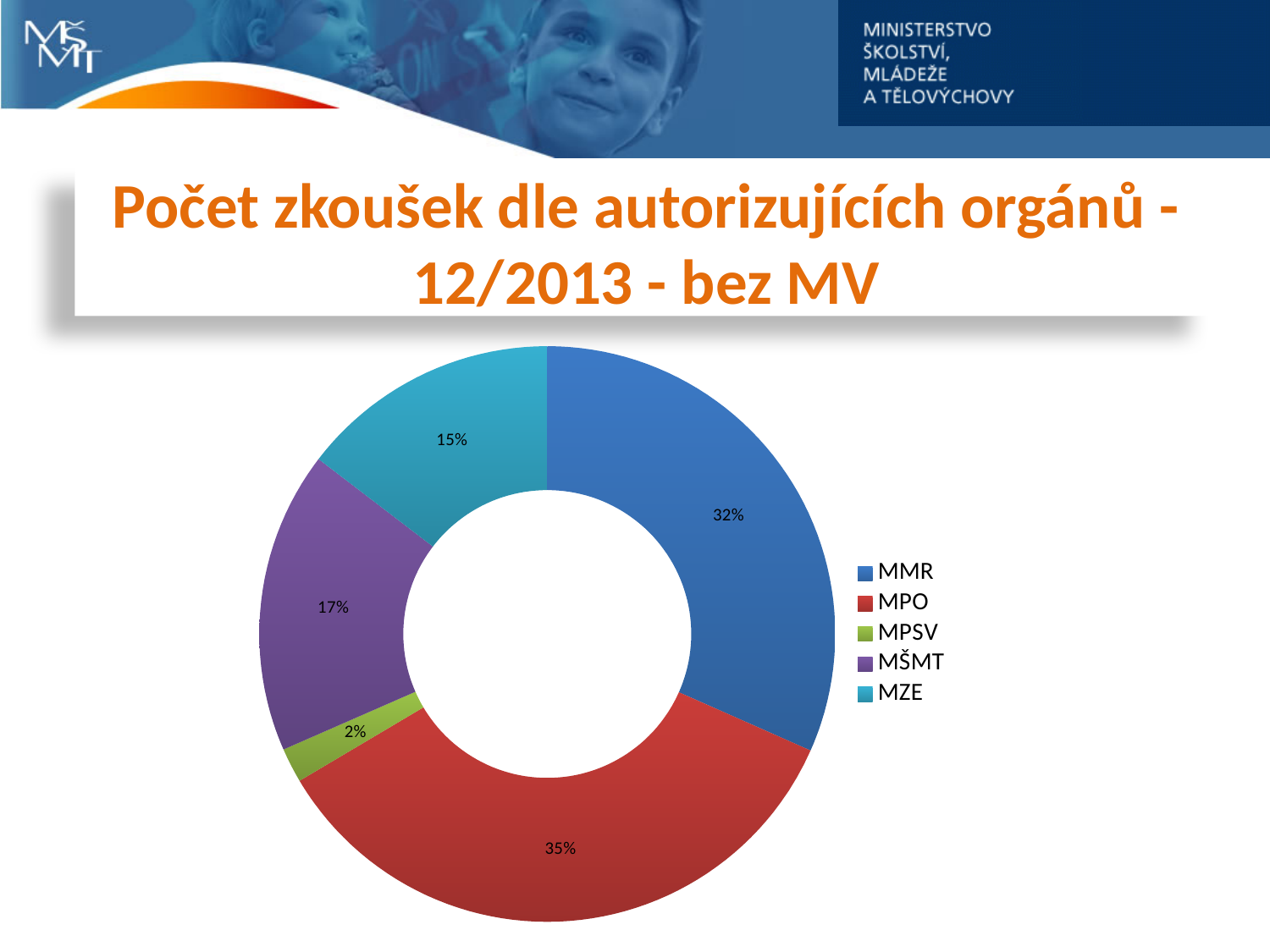
What colour represents MZE in the chart? Teal (light blue) What is the difference in percentage points between the shares of MPO and MMR? 3% What share of the chart does MPO account for? 35% What share of the chart does MŠMT account for? 17% What share of the chart does MPSV account for? 2% Which category has the smallest share of the chart? MPSV Which category has the largest share of the chart? MPO Which has a larger share, MŠMT or MZE? MŠMT How many categories does the chart show? 5 What kind of chart is shown on the slide? Doughnut (pie) chart